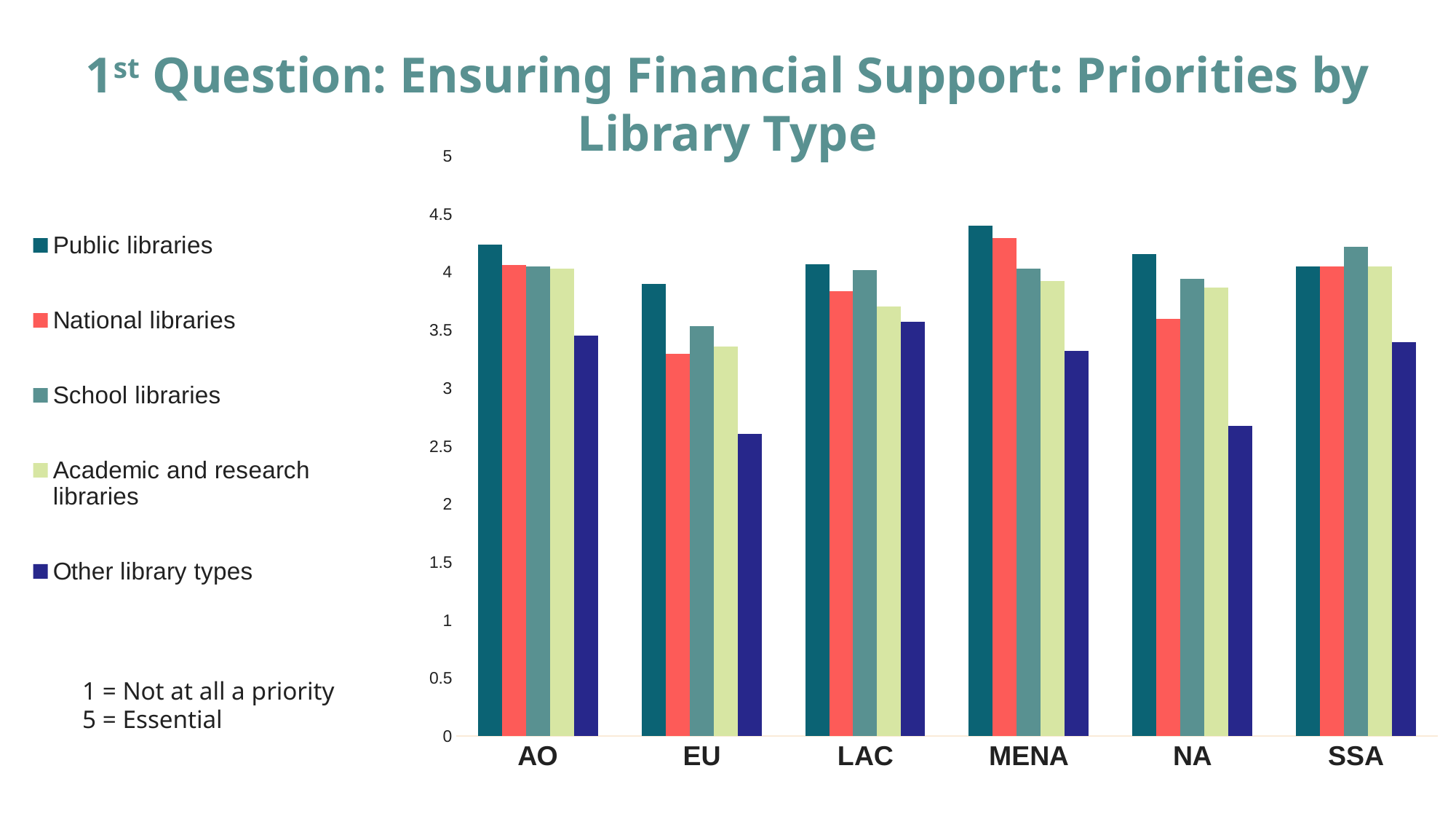
How many regions are shown along the x axis? 6 Is the value for Academic and research libraries in EU greater or less than 3.5? less Which region has the highest value for Public libraries? MENA How many series does the legend list? 5 Which region has the lowest value for Public libraries? EU According to the scale note on the slide, what does a value of 5 mean? Essential In EU, which is larger: the value for Public libraries or National libraries? Public libraries Is the value for Other library types in EU greater or less than 3? less Is the value for Other library types in NA greater or less than 3? less In NA, which is larger: the value for National libraries or School libraries? School libraries What kind of chart is shown on the slide? bar chart